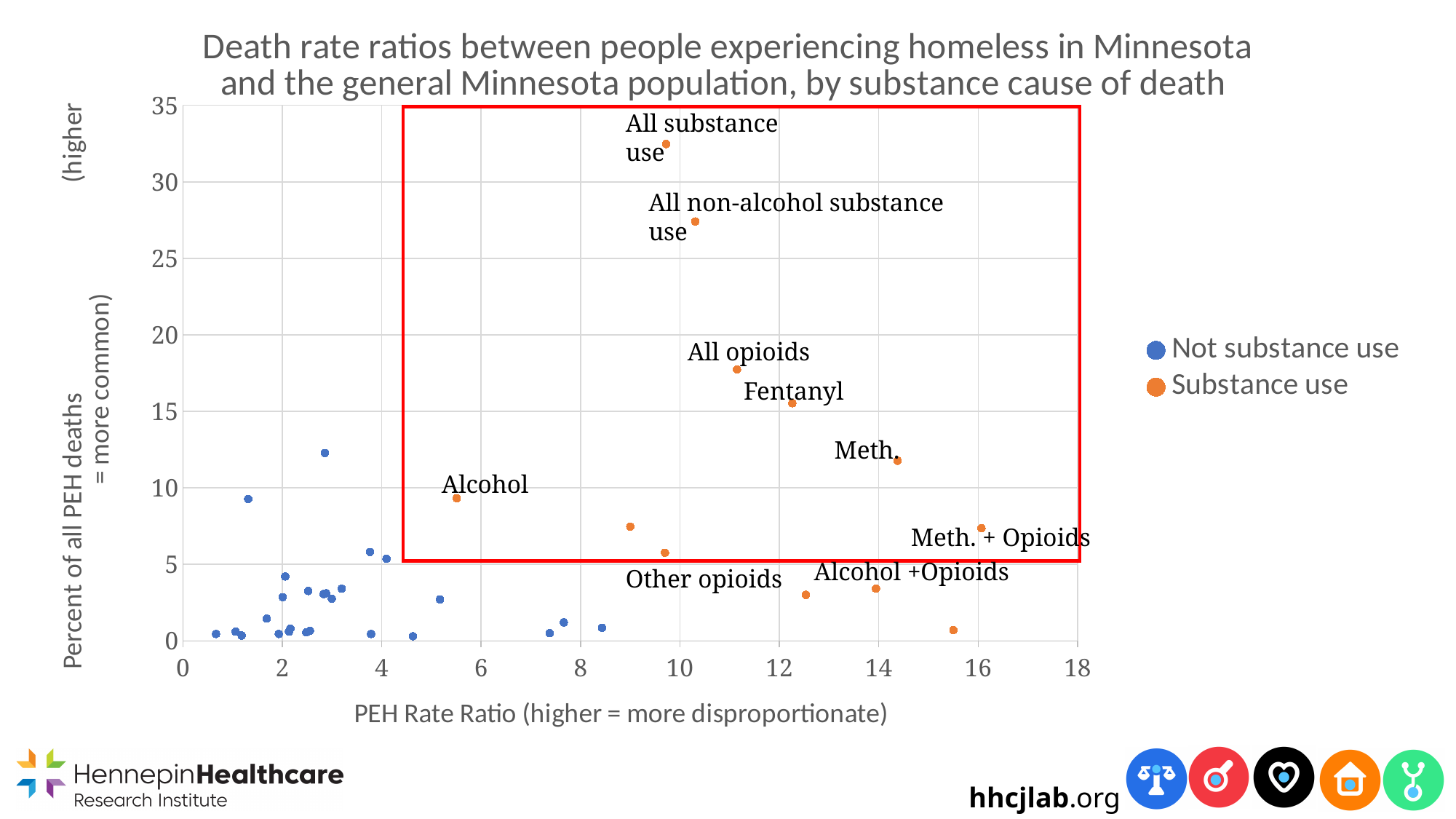
Is the percent of all PEH deaths for All substance use greater or less than 30? greater Is the percent of all PEH deaths for Fentanyl greater or less than 10? greater Is the PEH rate ratio for Alcohol greater or less than 6? less What is the title of the x axis? PEH Rate Ratio (higher = more disproportionate) What are the two series named in the legend? Not substance use; Substance use Which labeled substance cause of death has the highest PEH rate ratio? Meth. + Opioids What kind of chart is shown on the slide? Scatter chart Which has the higher percent of all PEH deaths, All opioids or Fentanyl? All opioids How many series does the legend list? 2 Which labeled substance cause of death has the highest percent of all PEH deaths? All substance use Which has the higher PEH rate ratio, Meth. + Opioids or Alcohol? Meth. + Opioids